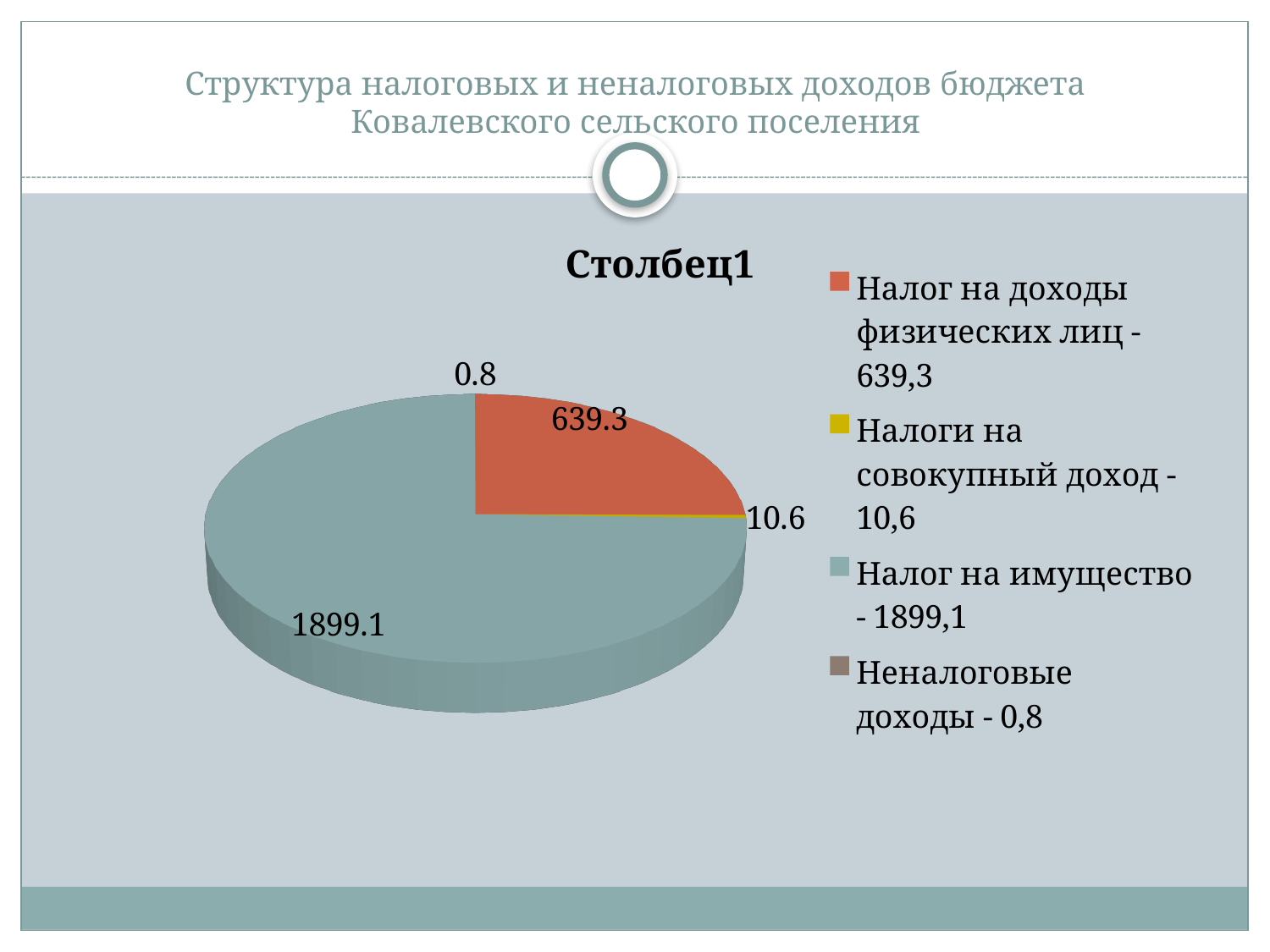
Which category has the largest slice of the pie? Налог на имущество What is the value for Налог на доходы физических лиц? 639.3 What colour is the slice for Налог на доходы физических лиц? red Which category has the smallest slice of the pie? Неналоговые доходы What is the difference between the values for Налог на имущество and Налог на доходы физических лиц? 1259.8 Which is larger, the value for Налоги на совокупный доход or the value for Неналоговые доходы? Налоги на совокупный доход What is the value for Налог на имущество? 1899.1 What is the value for Налоги на совокупный доход? 10.6 What is the title of the chart? Столбец1 What kind of chart is shown on the slide? pie chart How many slices does the pie chart have? 4 What is the value for Неналоговые доходы? 0.8